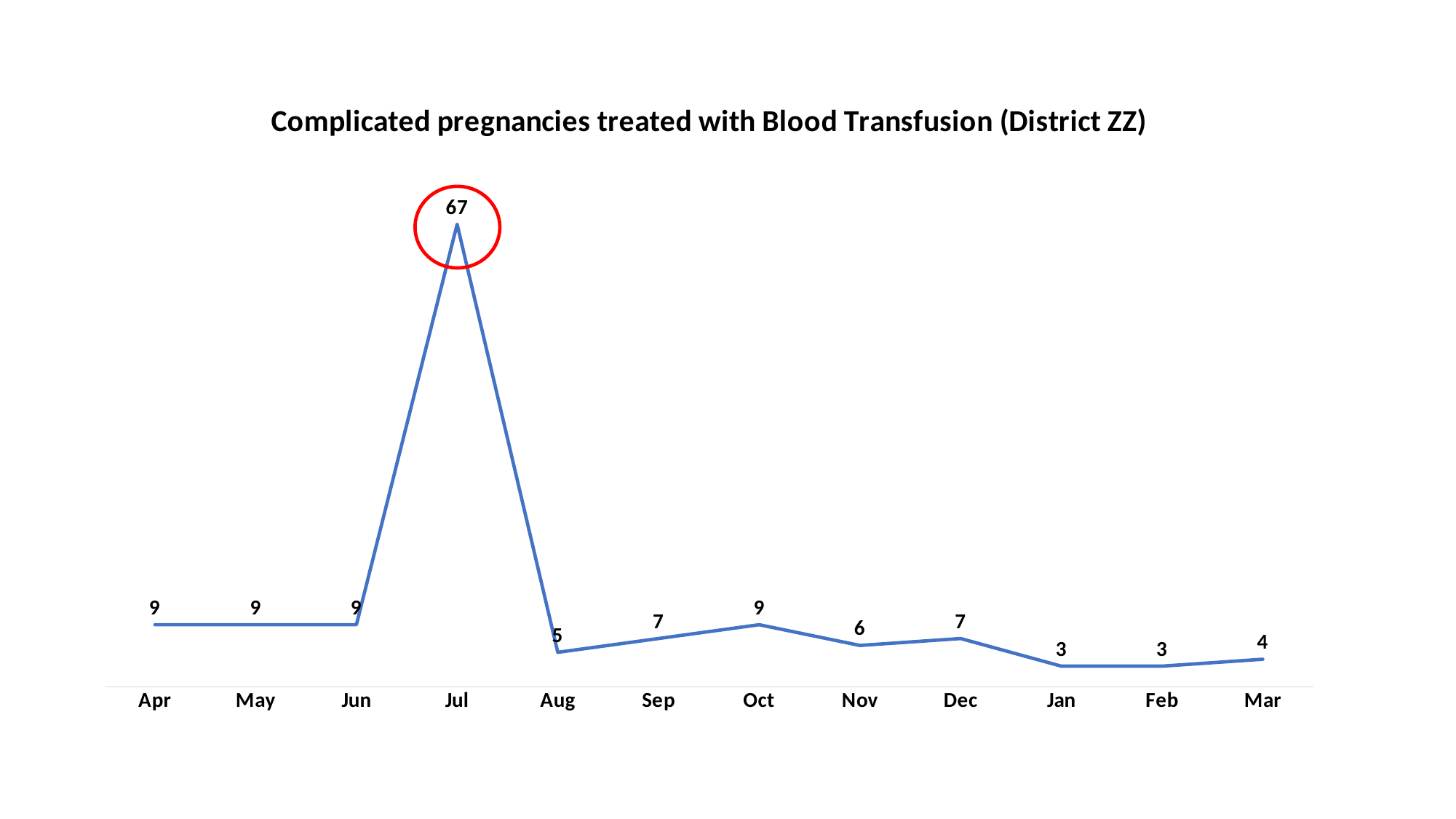
What is the value for Jul? 67 What is the difference between the values for Oct and Nov? 3 Which data point is highlighted with a red circle? Jul What is the difference between the values for Jul and Jun? 58 What kind of chart is this? line chart How many months are plotted on the x axis? 12 What is the title of the chart? Complicated pregnancies treated with Blood Transfusion (District ZZ) Which is larger, the value for Sep or the value for Mar? Sep What is the value for Aug? 5 Do the values rise or fall from Dec to Jan? fall What is the value for Nov? 6 Which month has the highest value? Jul